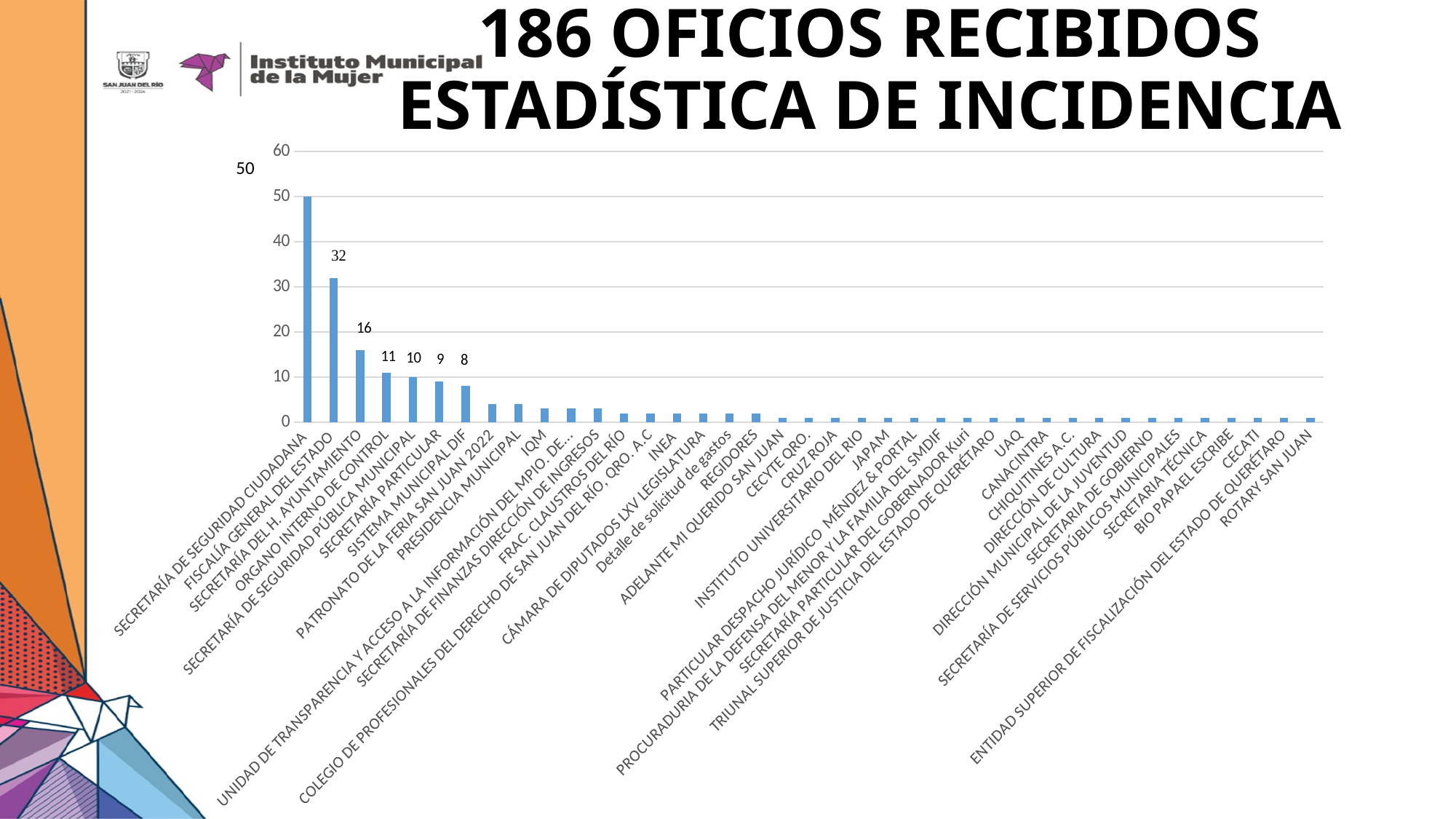
Is the value for PRESIDENCIA MUNICIPAL greater or less than 10? less What is the value for SISTEMA MUNICIPAL DIF? 8 What is the difference between the values for SECRETARÍA DE SEGURIDAD CIUDADANA and FISCALÍA GENERAL DEL ESTADO? 18 Which has a larger value, SECRETARÍA DEL H. AYUNTAMIENTO or SECRETARÍA DE SEGURIDAD PÚBLICA MUNICIPAL? SECRETARÍA DEL H. AYUNTAMIENTO What is the value for SECRETARÍA DE SEGURIDAD CIUDADANA? 50 Which category has the highest value? SECRETARÍA DE SEGURIDAD CIUDADANA What is the title of the slide? 186 OFICIOS RECIBIDOS ESTADÍSTICA DE INCIDENCIA What kind of chart is shown on the slide? bar chart What is the value for SECRETARÍA DEL H. AYUNTAMIENTO? 16 What is the value for FISCALÍA GENERAL DEL ESTADO? 32 What is the difference between the values for ORGANO INTERNO DE CONTROL and SECRETARÍA PARTICULAR? 2 Do the values rise or fall from left to right along the x axis? fall